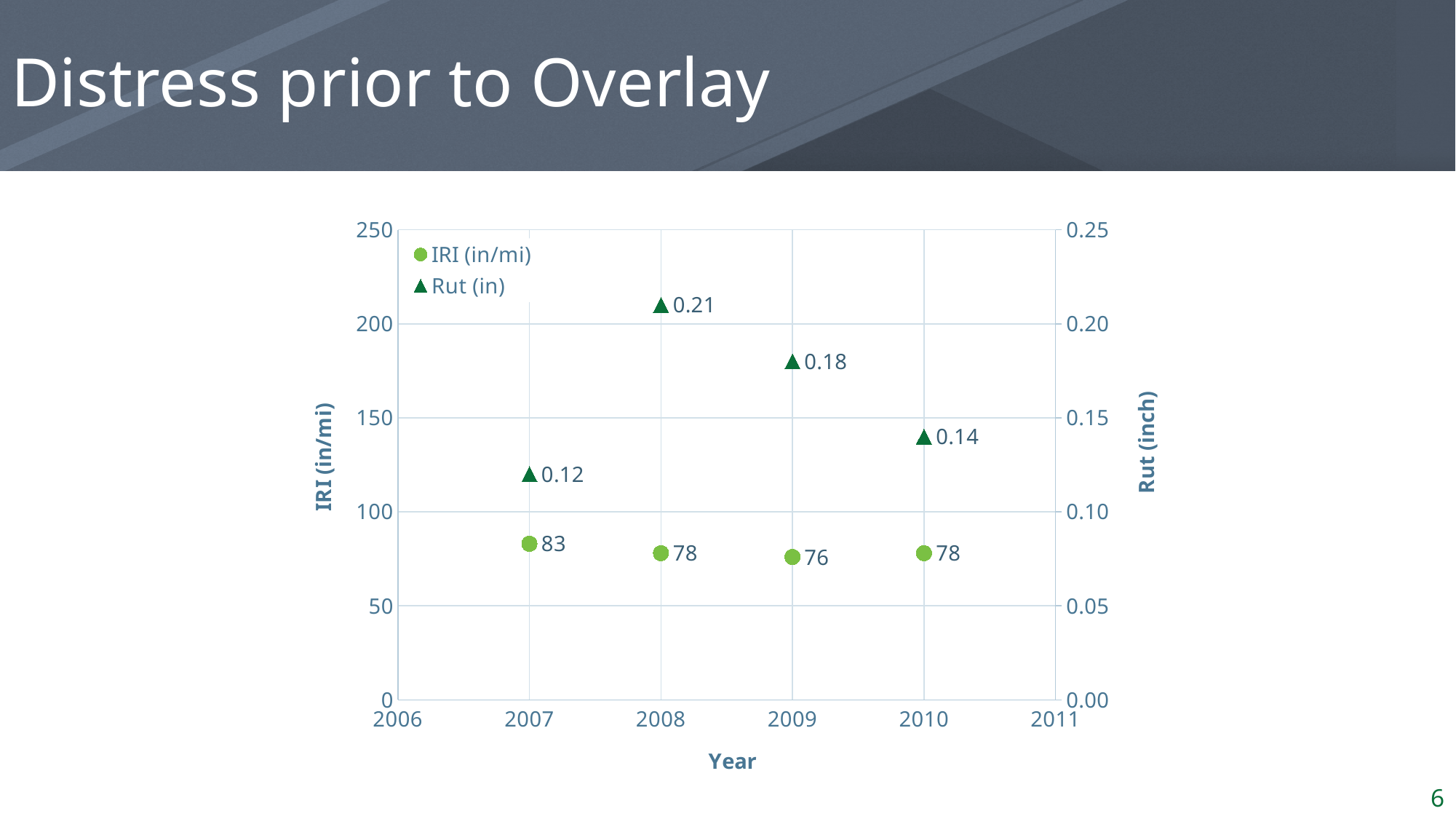
What is the title of the slide containing the chart? Distress prior to Overlay How many data points are plotted for the IRI (in/mi) series? 4 Which is larger, the Rut (in) value for 2009 or for 2010? 2009 What is the IRI (in/mi) value for 2007? 83 What is the Rut (in) value for 2010? 0.14 How many series does the legend list? 2 In which year is the IRI (in/mi) value lowest? 2009 What is the difference between the Rut (in) values for 2008 and 2007? 0.09 What is the IRI (in/mi) value for 2009? 76 What is the Rut (in) value for 2008? 0.21 What is the difference between the IRI (in/mi) values for 2007 and 2009? 7 In which year is the Rut (in) value highest? 2008